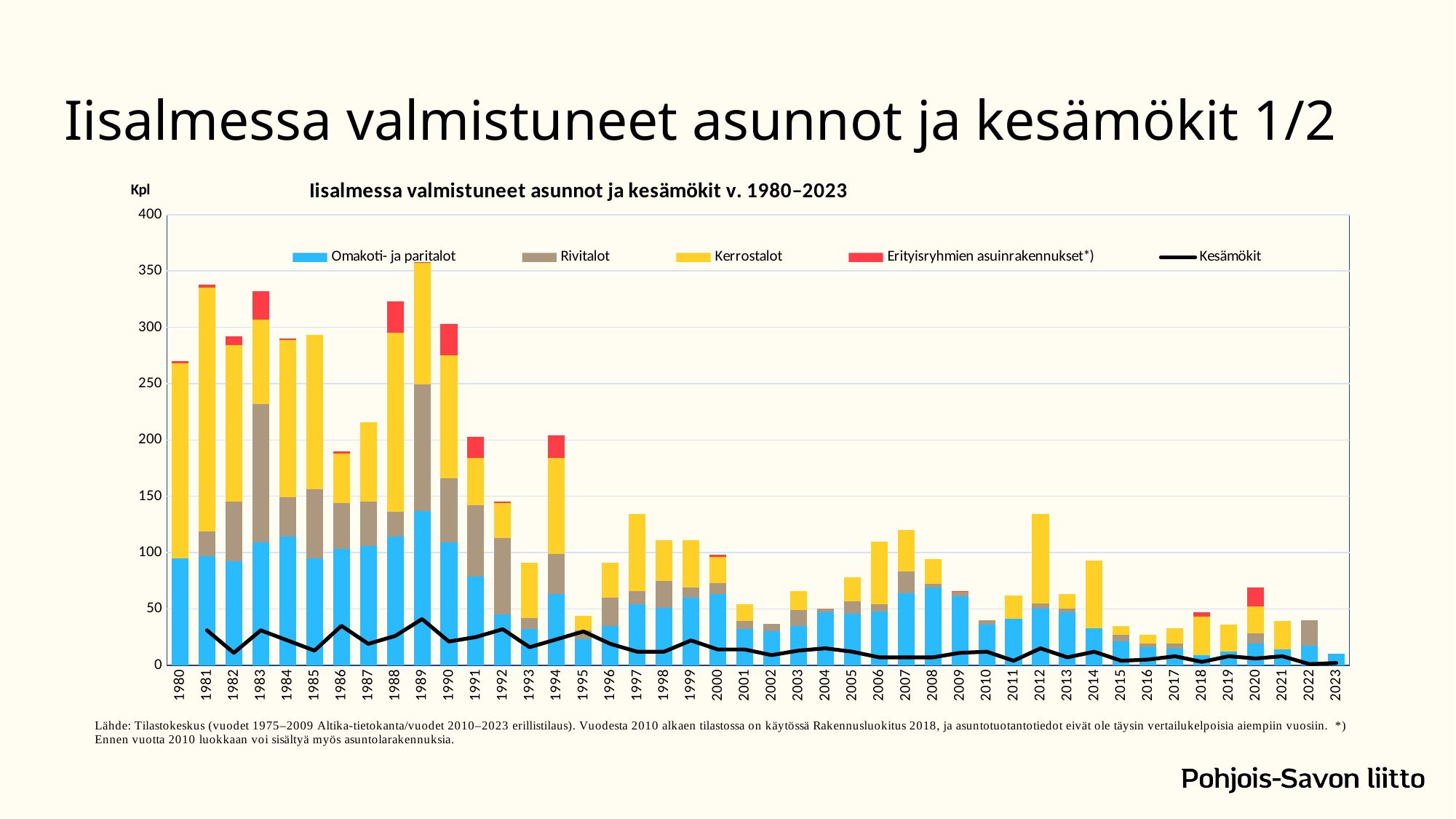
Which year has the larger total stacked bar, 1981 or 1982? 1981 Is the total stacked bar for 2012 greater or less than 100? greater Is the total stacked bar for 1989 greater or less than 300? greater Which colour represents the Kerrostalot series in the chart? yellow What is the title of the chart? Iisalmessa valmistuneet asunnot ja kesämökit v. 1980–2023 What kind of chart is shown on the slide? stacked bar and line chart In which year is the total stacked bar the highest? 1989 In which year is the total stacked bar the lowest? 2023 How many series does the chart legend list? 5 Do the total stacked bars generally rise or fall from 1980 to 2023? fall How many years are shown along the x axis of the chart? 44 Is the total stacked bar for 2023 greater or less than 50? less